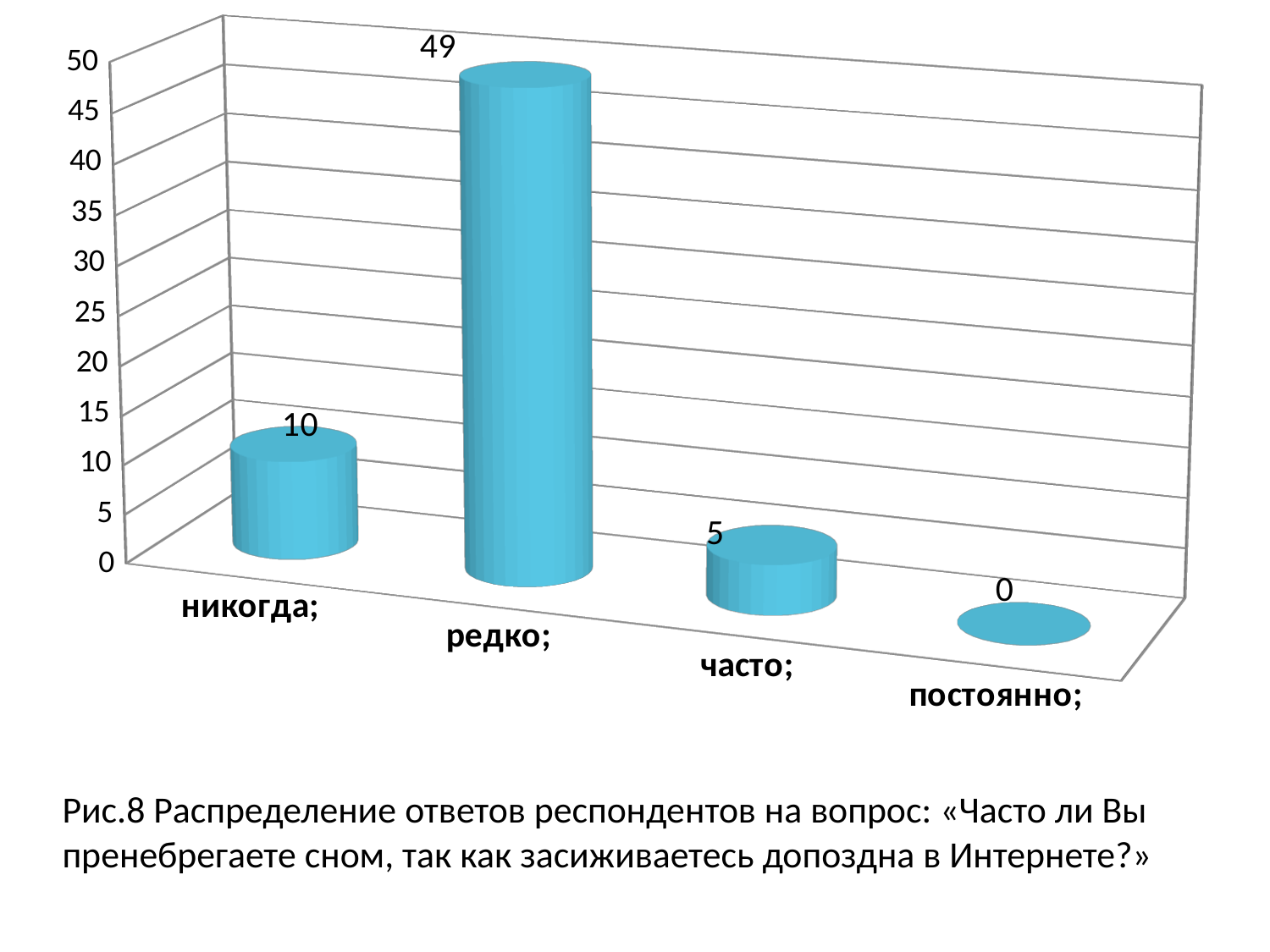
What is the difference between the values for "никогда;" and "часто;"? 5 What is the value for "часто;"? 5 Which category has the lowest value? постоянно; What is the value for "никогда;"? 10 What kind of chart is shown on the slide? bar chart What is the figure number given in the caption below the chart? Рис.8 What is the value for "постоянно;"? 0 What is the difference between the values for "редко;" and "никогда;"? 39 How many categories are shown on the chart? 4 Which category has the highest value? редко; Which is larger, the value for "никогда;" or the value for "часто;"? никогда; What is the value for "редко;"? 49